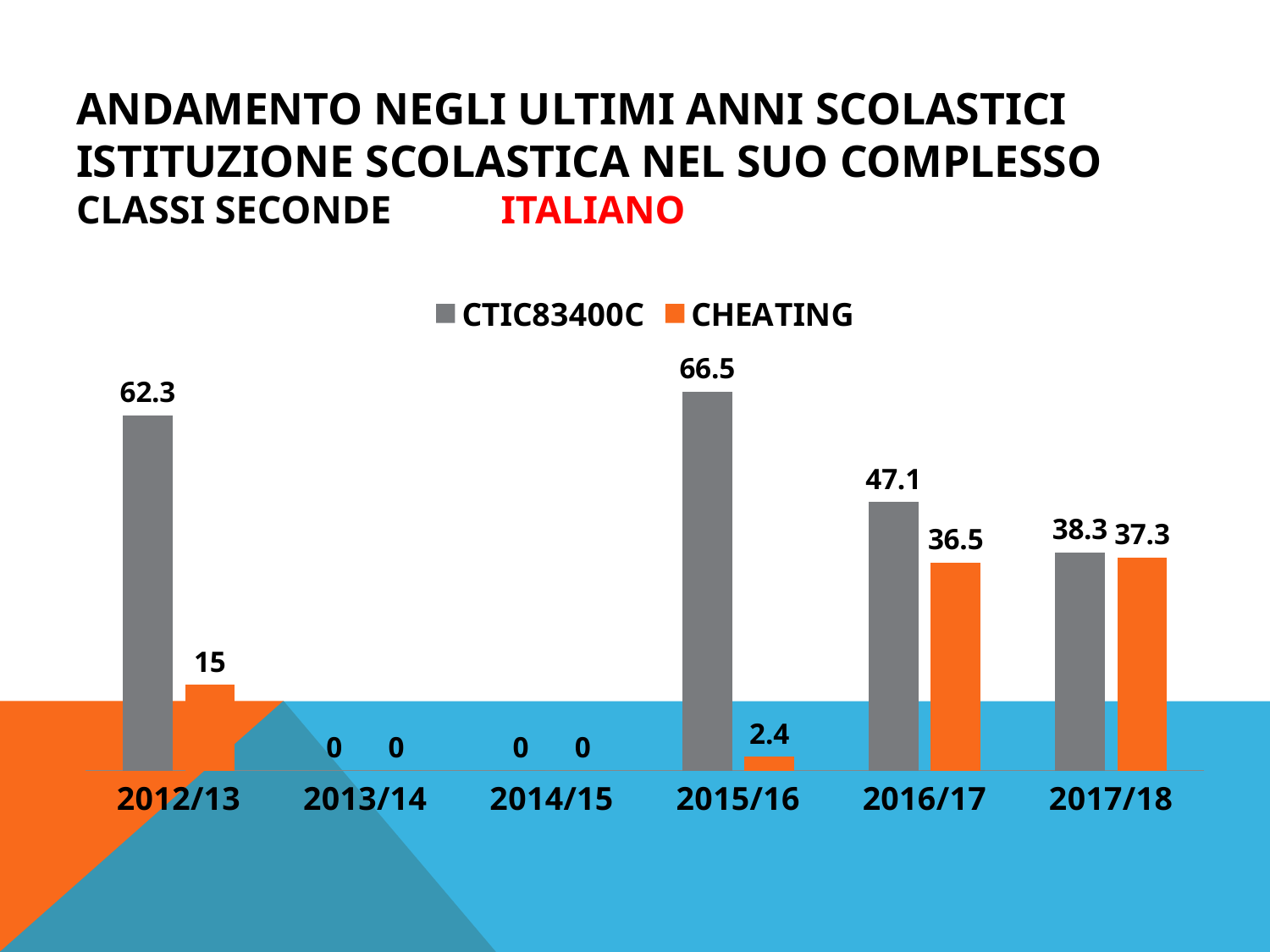
How many school years are shown on the x axis? 6 Which colour represents the CHEATING series? Orange What is the CTIC83400C value for 2015/16? 66.5 In 2016/17, which is larger: CTIC83400C or CHEATING? CTIC83400C Which school year has the highest CHEATING value? 2017/18 How many series does the legend list? 2 Which school year has the highest CTIC83400C value? 2015/16 What is the difference between the CTIC83400C values for 2015/16 and 2016/17? 19.4 What is the CHEATING value for 2016/17? 36.5 What is the difference between the CTIC83400C and CHEATING values in 2017/18? 1 What is the CHEATING value for 2012/13? 15 What kind of chart is shown on the slide? Bar chart